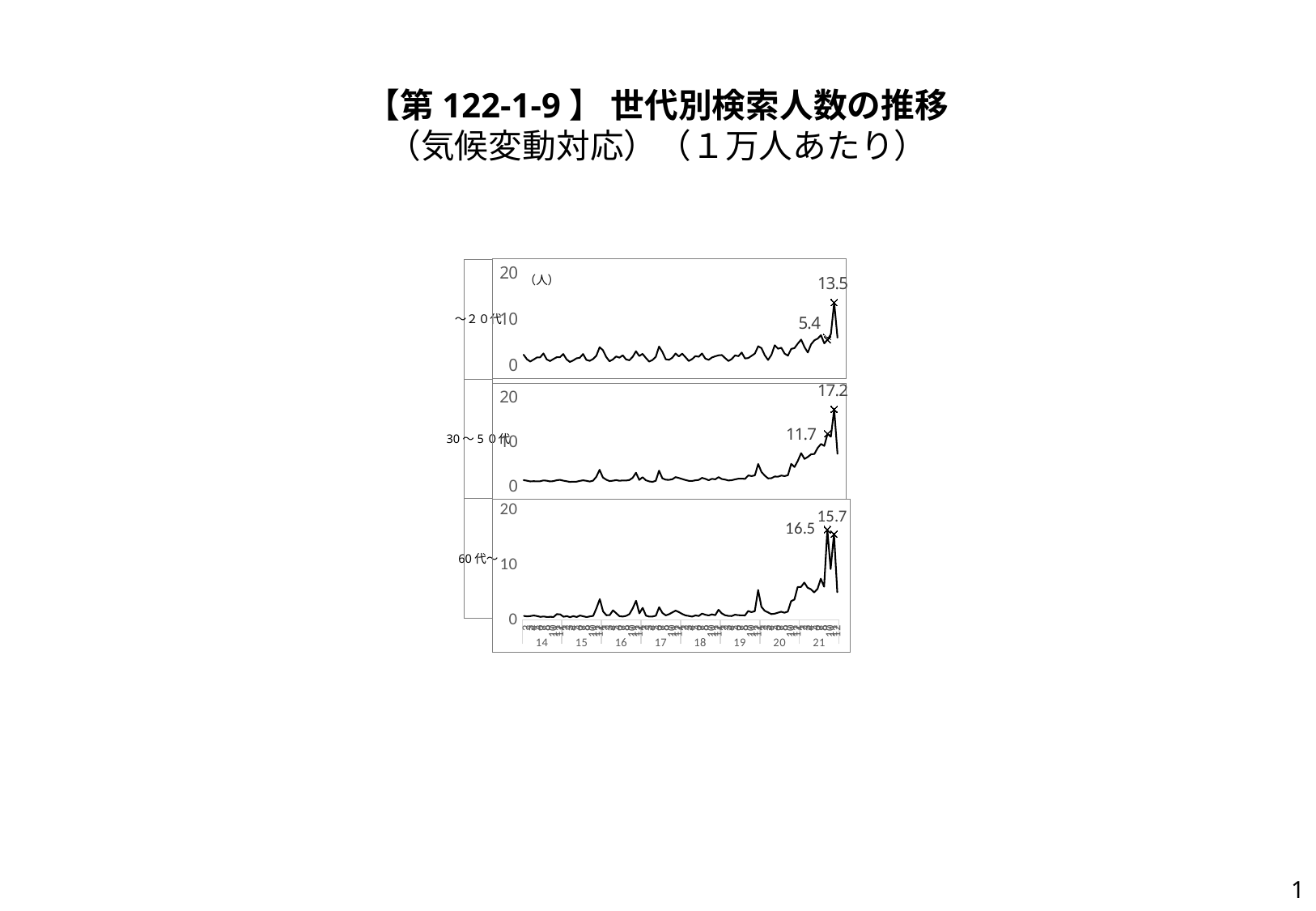
Is the peak labelled value in the top chart (～20代) greater or less than 10? greater In the middle chart (30～50代), what is the difference between the labelled values 17.2 and 11.7? 5.5 What kind of chart is used for each of the three panels on the slide? line chart In the middle chart (30～50代), what is the peak labelled value? 17.2 Which of the three age-group charts has the highest labelled peak value? 30～50代 (17.2) What is the first year shown on the shared x axis at the bottom of the charts? 14 In the bottom chart (60代～), what are the two labelled values? 16.5 and 15.7 In the top chart (～20代), what is the difference between the two labelled values, 13.5 and 5.4? 8.1 In the middle chart (30～50代), what is the labelled value just before the peak? 11.7 In the top chart (～20代), what is the highest labelled value? 13.5 In the bottom chart (60代～), which labelled value is larger, 16.5 or 15.7? 16.5 In the top chart (～20代), what is the lower of the two labelled values? 5.4